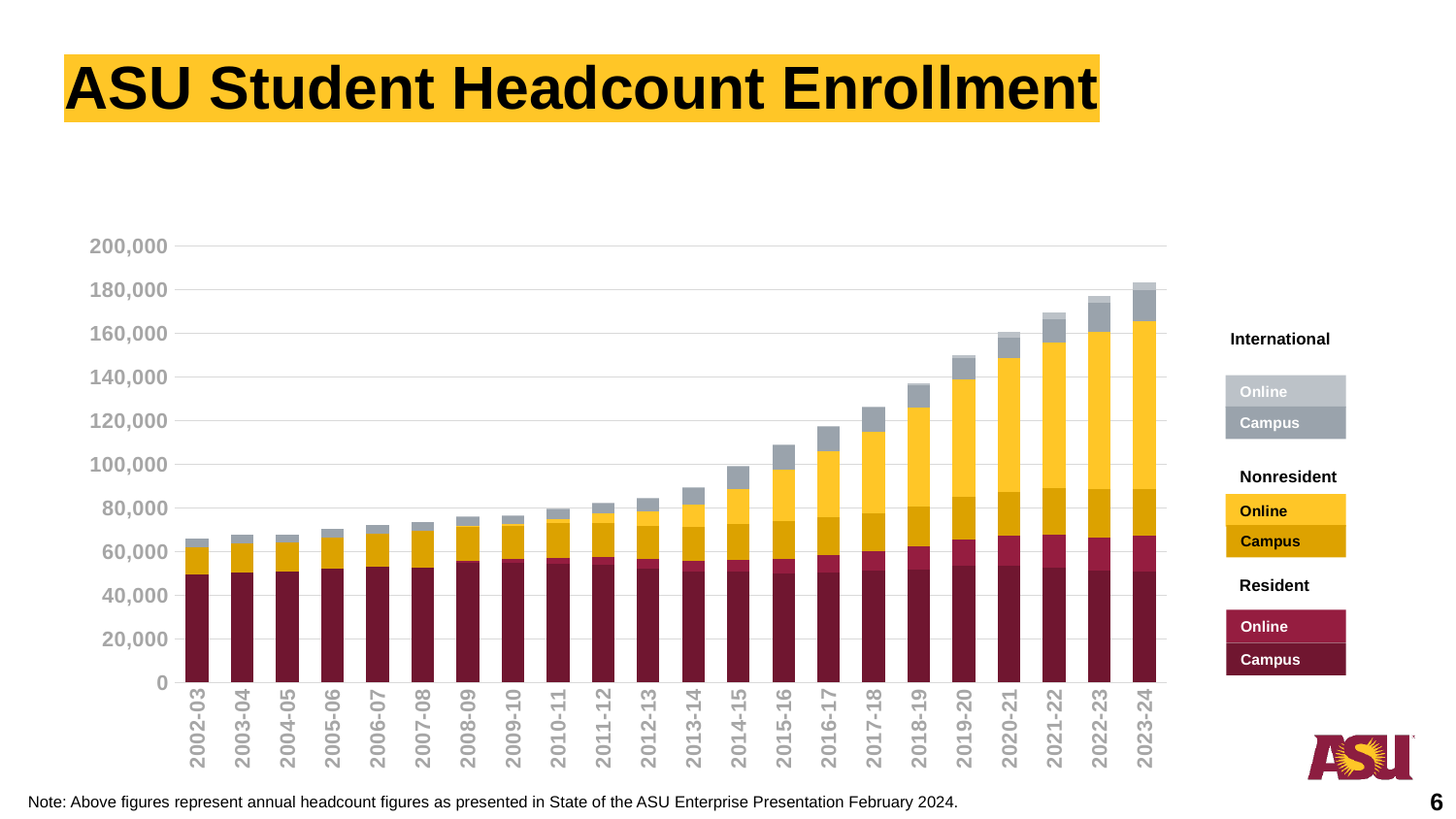
Is the total headcount for 2002-03 greater or less than 80,000? less Which academic year has the highest total headcount? 2023-24 Is the total headcount for 2023-24 greater or less than 160,000? greater Is the total headcount for 2015-16 greater or less than 100,000? greater What kind of chart is shown on the slide? Stacked bar chart What is the title of the chart? ASU Student Headcount Enrollment Which has the larger total headcount, 2014-15 or 2019-20? 2019-20 What are the three student groups named in the legend? International, Nonresident, Resident Do the total headcount values generally rise or fall from 2002-03 to 2023-24? Rise How many series does the legend list? 6 How many academic years are shown along the x axis? 22